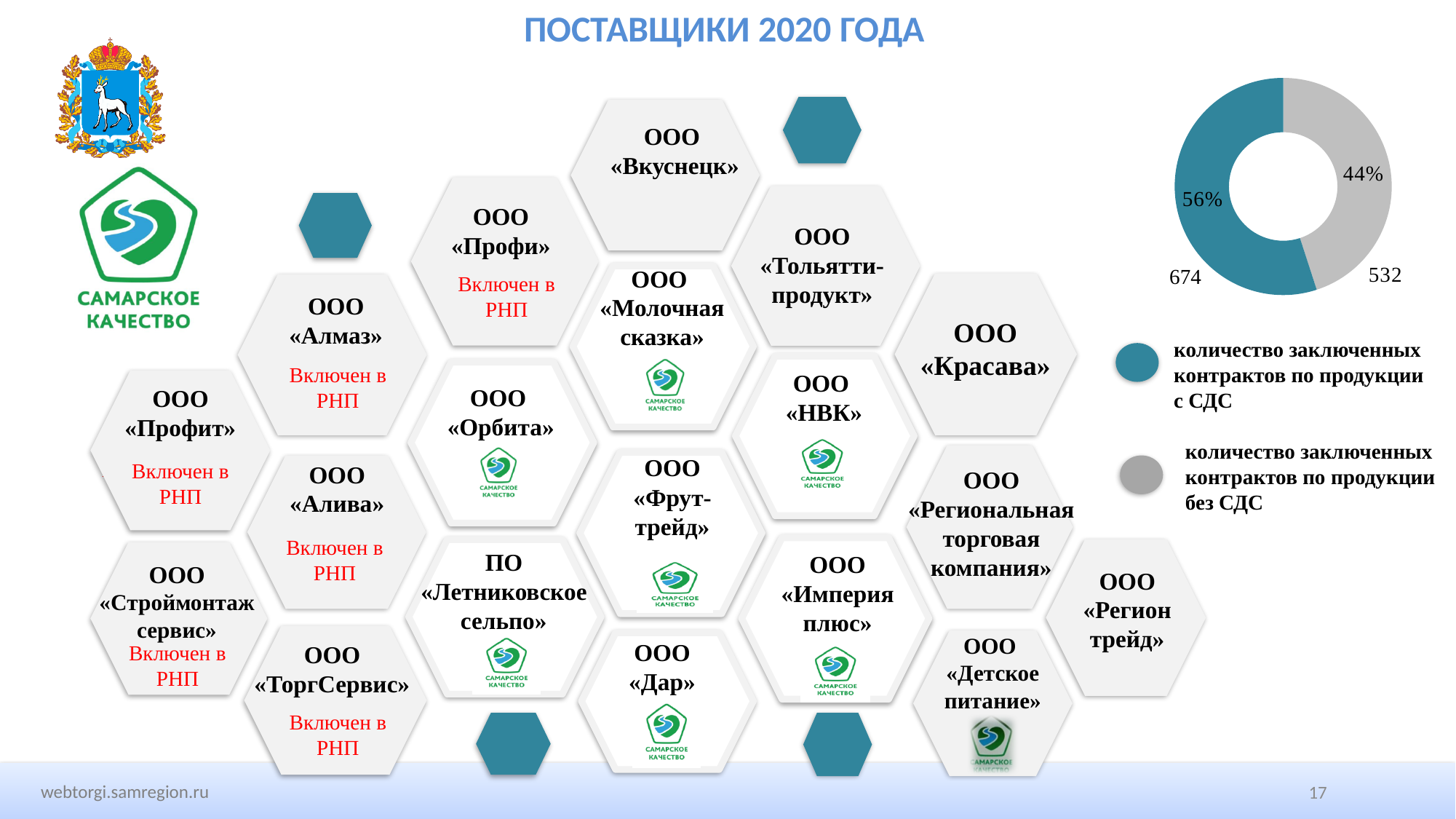
What kind of chart is shown on the slide? Donut (pie) chart Which category has the larger share of contracts: with СДС or without СДС? With СДС What percentage of contracts were concluded for products without СДС? 44% How many categories does the donut chart show? 2 Which category has the smallest number of contracts? Contracts for products without СДС What is the difference in the number of contracts between products with СДС and without СДС? 142 What colour represents contracts for products with СДС in the chart? Teal (blue-green) How many contracts were concluded for products with СДС? 674 What is the total number of contracts shown in the chart? 1206 How many entries does the chart legend list? 2 What percentage of contracts were concluded for products with СДС? 56% How many contracts were concluded for products without СДС? 532